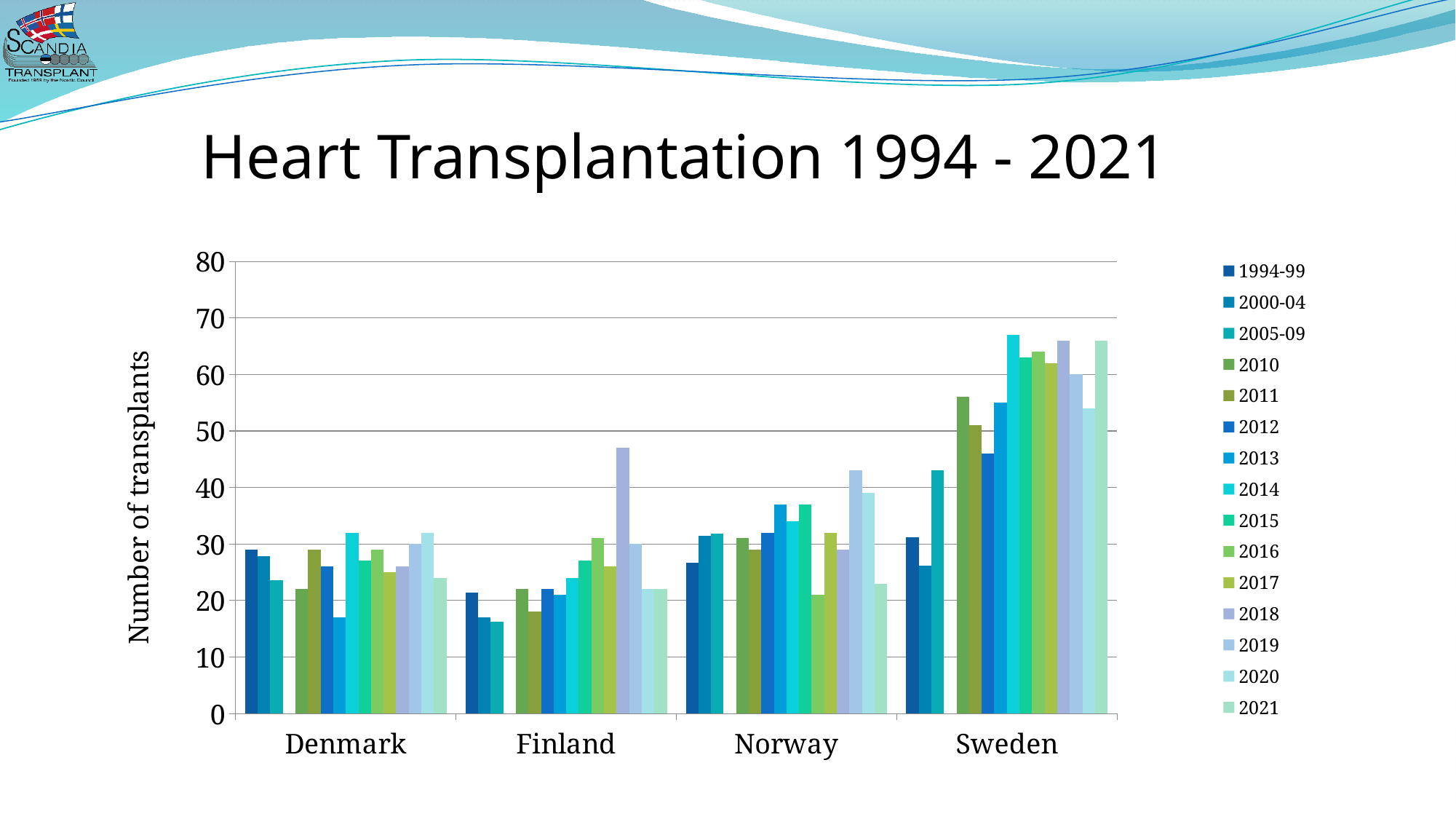
How many series does the legend list? 15 Is the value for Finland in 2018 greater or less than 50? less What is the label on the vertical axis of the chart? Number of transplants Which is larger, the value for Finland in 2018 or the value for Norway in 2018? Finland in 2018 What kind of chart is shown on the slide? bar chart Which country has the highest number of heart transplants overall in the chart? Sweden For Finland, which period has the highest bar? 2018 Which is larger, the value for Norway in 2013 or the value for Denmark in 2013? Norway in 2013 Is the value for Sweden in 2014 greater or less than 60? greater How many countries are shown on the x axis of the chart? 4 Which country has the lowest number of heart transplants overall in the chart? Finland Is the value for Norway in 2017 greater or less than 30? greater